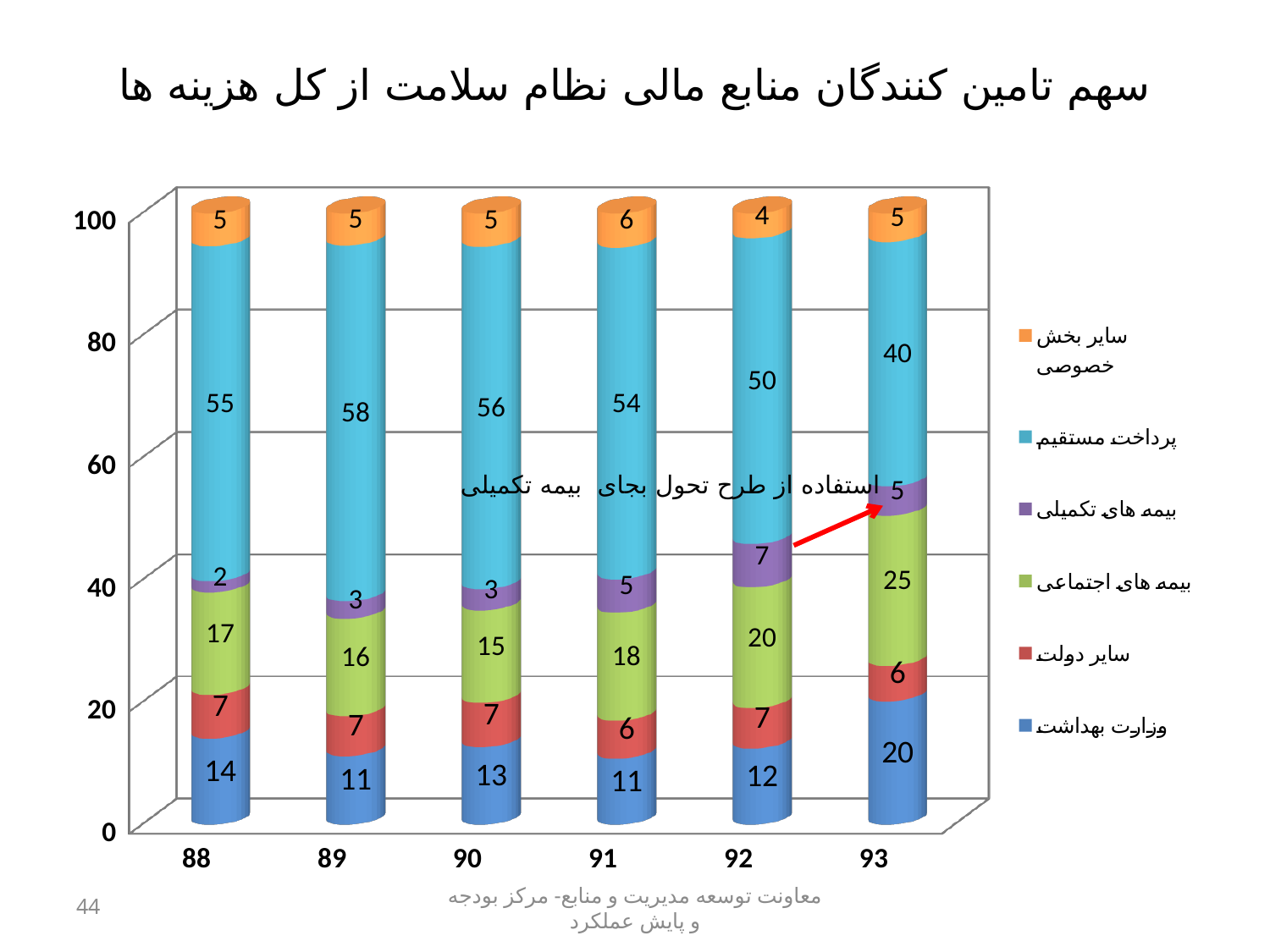
What is the value of پرداخت مستقیم for year 93? 40 Which is larger, the بیمه های اجتماعی value for year 93 or for year 88? Year 93 What is the total of the stacked bar for year 92? 100 What is the difference between the پرداخت مستقیم values for years 89 and 93? 18 How many years are shown on the x axis? 6 In which year is the پرداخت مستقیم segment the lowest? 93 What is the value of بیمه های اجتماعی for year 92? 20 What is the value of وزارت بهداشت for year 88? 14 Which legend entry is shown in orange? سایر بخش خصوصی In which year is the پرداخت مستقیم segment the highest? 89 How many series does the legend list? 6 What kind of chart is shown on the slide? Stacked bar chart